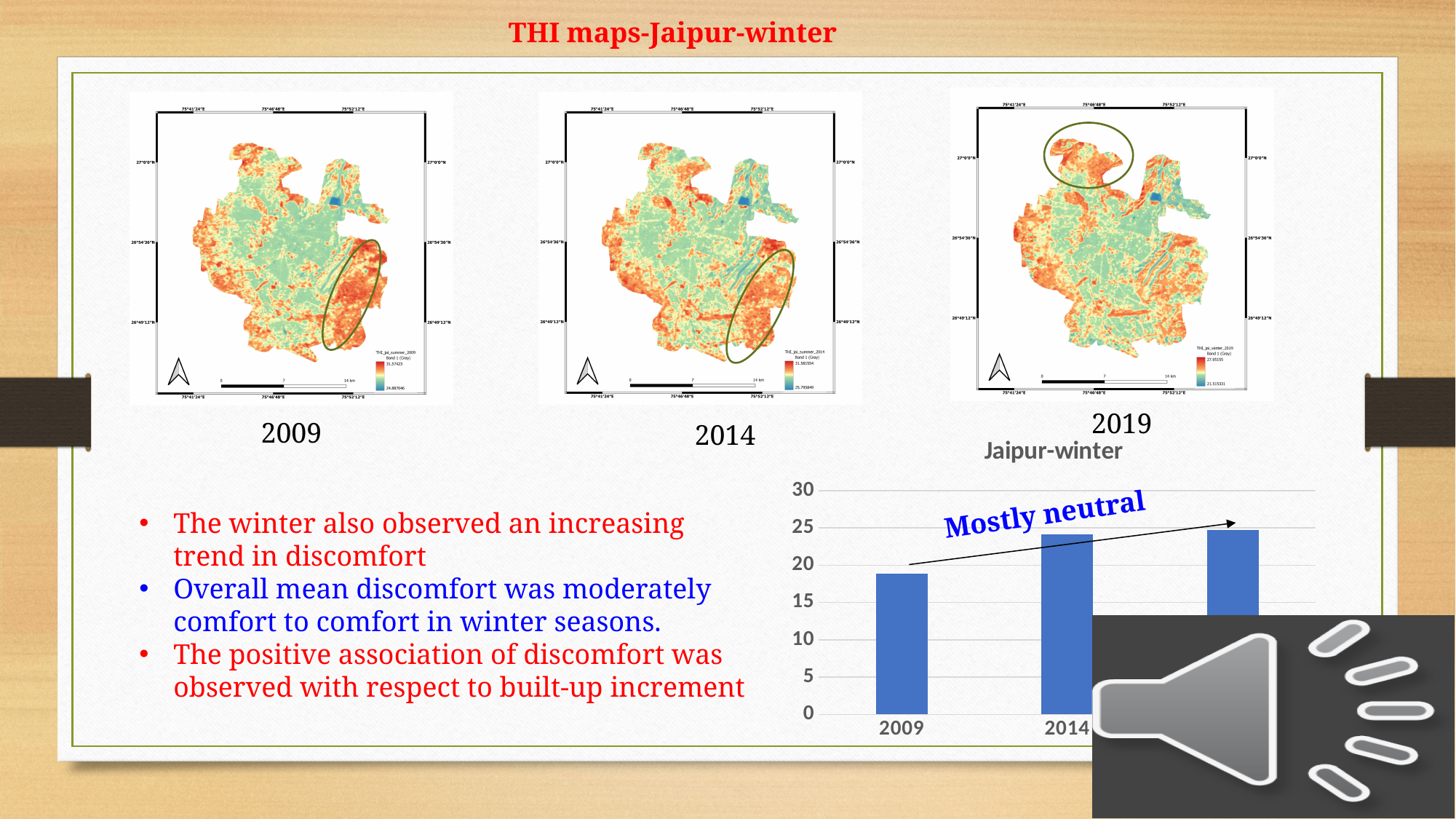
How many bars are plotted in the Jaipur-winter chart? 3 What is the title of the bar chart on the slide? Jaipur-winter In the Jaipur-winter chart, is the value for 2014 greater or less than 20? greater In the Jaipur-winter chart, is the value for 2009 greater or less than 25? less In the Jaipur-winter chart, which is larger, the value for 2009 or the value for 2014? 2014 In the Jaipur-winter chart, is the value for 2009 greater or less than 15? greater What kind of chart is the Jaipur-winter chart? bar chart In the Jaipur-winter chart, which year has the lowest bar? 2009 In the Jaipur-winter chart, do the values rise or fall from left to right along the x axis? rise What is the highest value shown on the y axis of the Jaipur-winter chart? 30